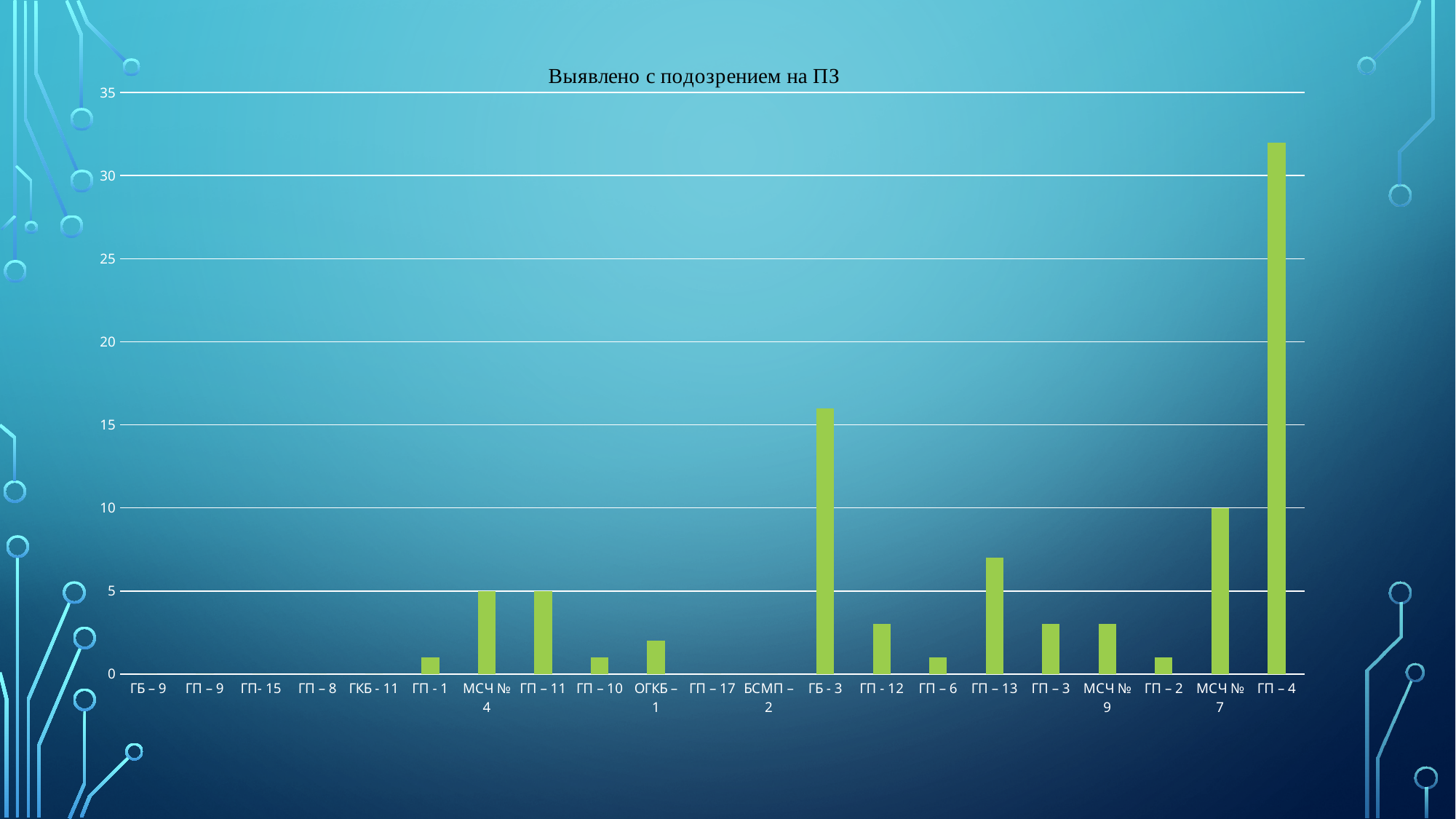
Which category has the highest value? ГП – 4 What is the title of the chart? Выявлено с подозрением на ПЗ Is the value for ГБ - 3 greater or less than 15? greater What is the difference between the values for МСЧ № 7 and МСЧ № 4? 5 Which is larger, the value for ГБ - 3 or the value for МСЧ № 7? ГБ - 3 What is the value for МСЧ № 7? 10 Is the value for ОГКБ – 1 greater or less than 5? less What kind of chart is shown on the slide? bar chart What is the value for ГП – 11? 5 What is the value for МСЧ № 4? 5 Is the value for ГП – 4 greater or less than 30? greater How many categories are shown on the x axis? 21